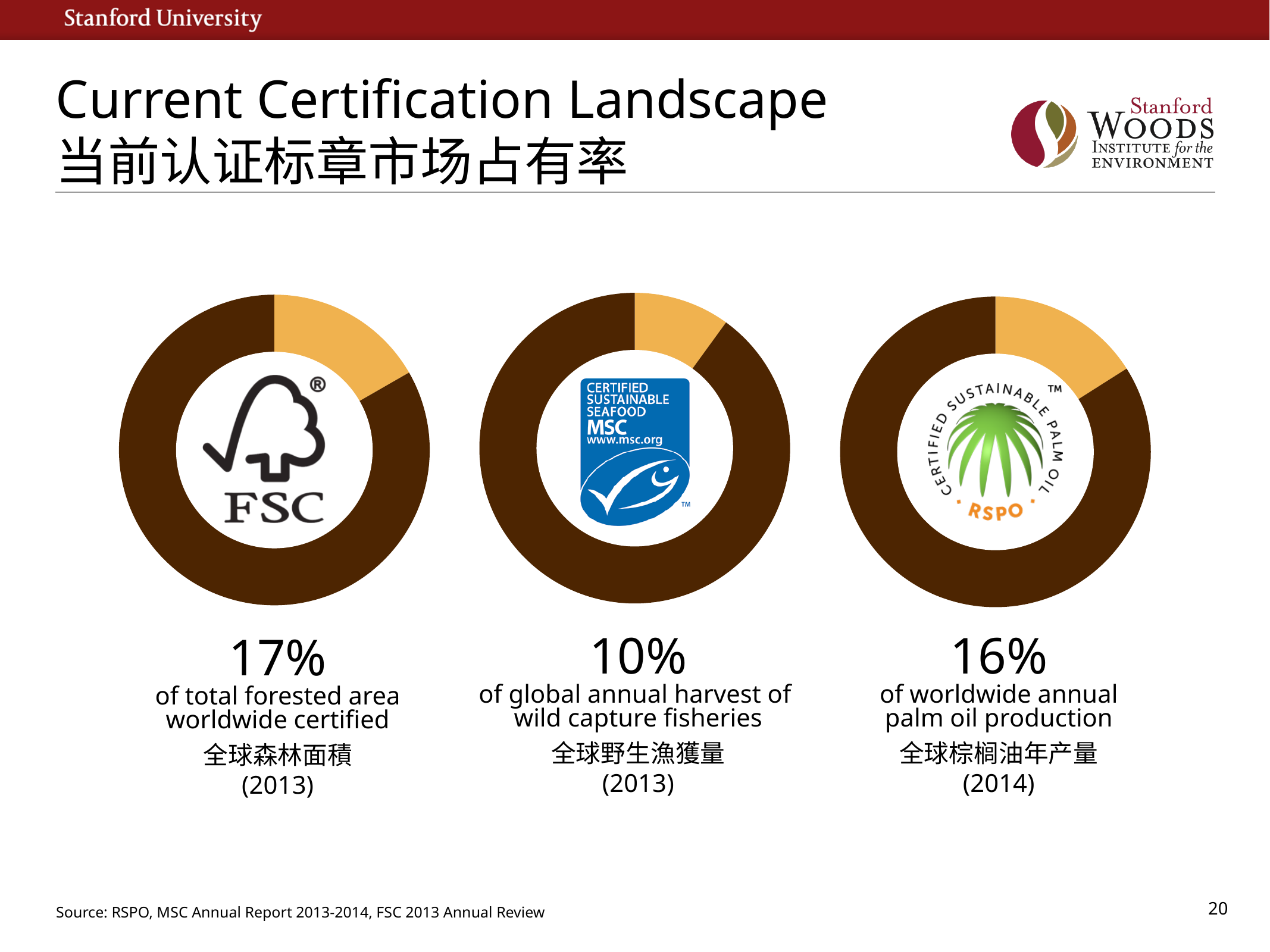
Across the three donut charts, which certification scheme has the highest certified share? FSC What kind of chart is used to show each certification share on this slide? Donut (pie) chart On the MSC donut chart (middle), what percentage of the global annual harvest of wild capture fisheries is certified? 10% Which year is given for the RSPO palm oil production figure? 2014 What is the difference between the certified share shown on the RSPO chart and the certified share shown on the MSC chart? 6% On the FSC donut chart (left), what percentage of total forested area worldwide is certified? 17% How many donut charts are shown on the slide? 3 On the RSPO donut chart (right), what percentage of worldwide annual palm oil production is certified? 16% On the MSC donut chart (middle), what share of the ring is the uncertified (brown) portion? 90% Which is larger: the certified share on the FSC chart or the certified share on the RSPO chart? FSC What is the difference between the certified share shown on the FSC chart and the certified share shown on the MSC chart? 7% Across the three donut charts, which certification scheme has the lowest certified share? MSC